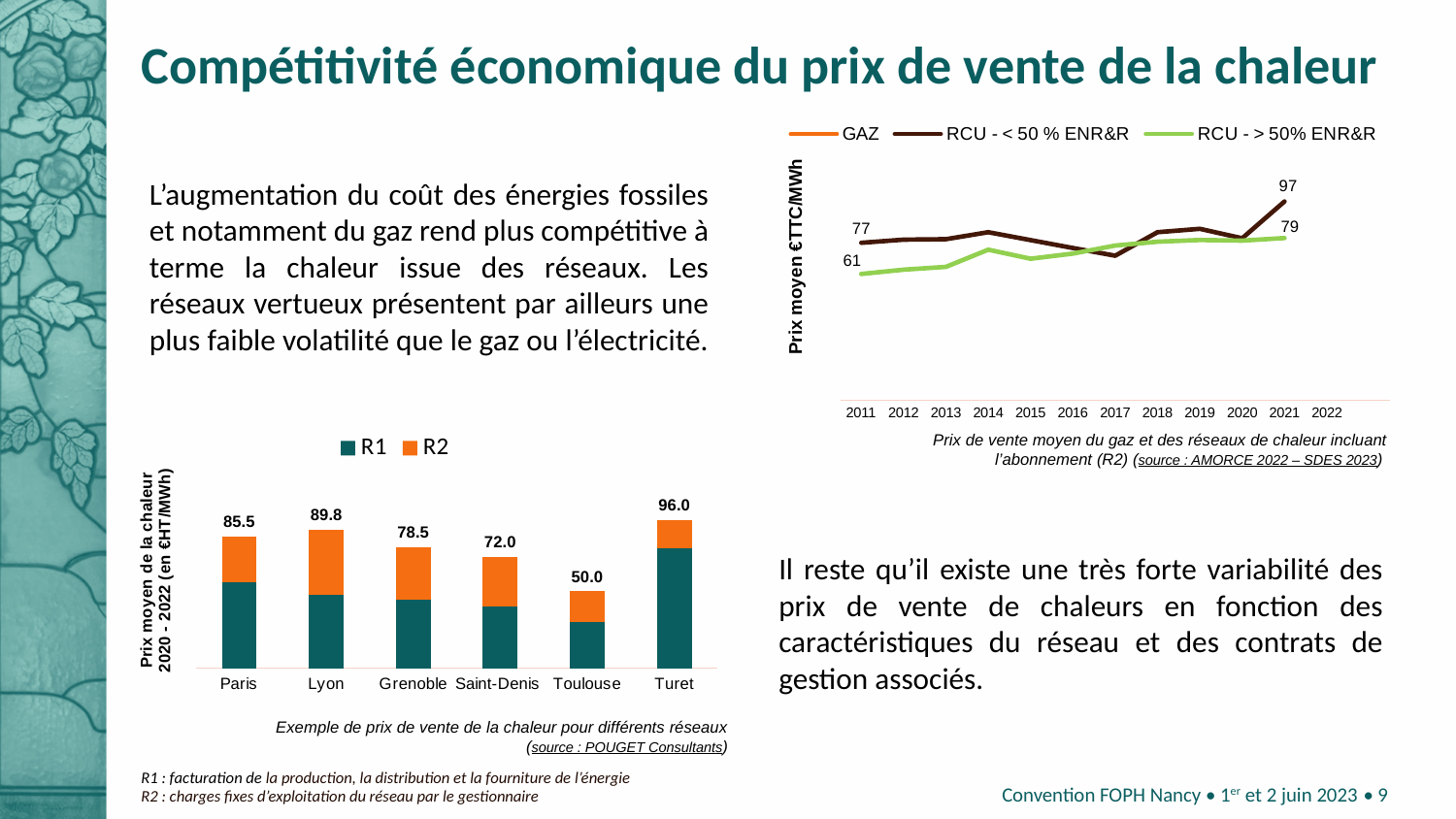
In the bar chart at the bottom left, what is the total value shown for Paris? 85.5 What kind of chart is the one at the bottom left of the slide? Stacked bar chart In the bar chart at the bottom left, which network has the highest total price? Turet In the bar chart at the bottom left, what is the total value shown for Toulouse? 50.0 In the bar chart at the bottom left, which has the larger total, Lyon or Grenoble? Lyon In the line chart at the top right, what is the highest data label shown? 97 In the line chart at the top right, how many series does the legend list? 3 In the bar chart at the bottom left, how many series does the legend list? 2 In the bar chart at the bottom left, which network has the lowest total price? Toulouse In the bar chart at the bottom left, what is the difference between the totals for Turet and Toulouse? 46.0 In the line chart at the top right, how many years are shown on the x axis? 12 In the bar chart at the bottom left, how many networks are shown on the x axis? 6